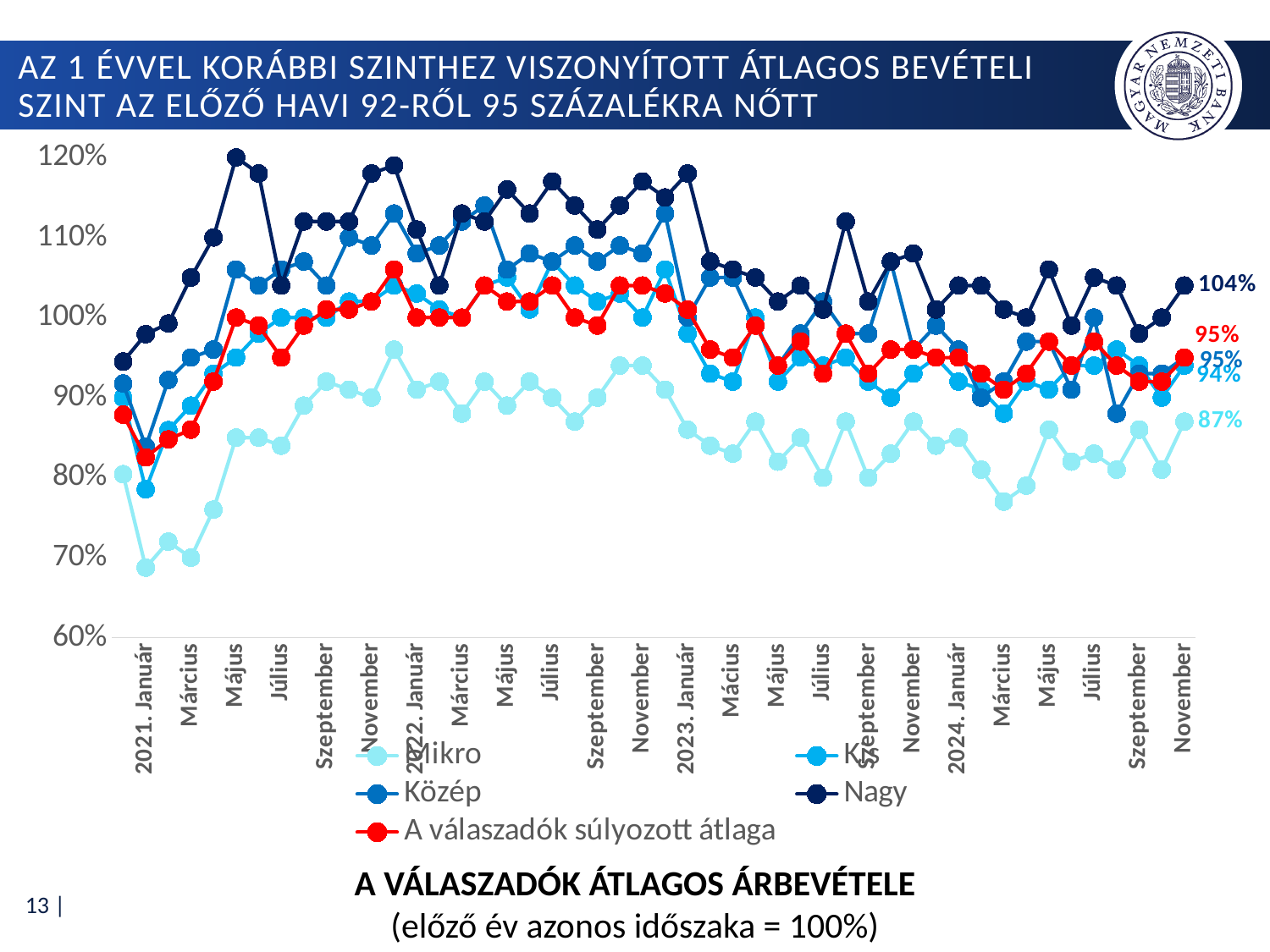
What is the value of the Nagy series at the last point (2024 November)? 104% What kind of chart is shown on the slide? line chart Which series has the lowest value at the last point (2024 November)? Mikro What is the value of the Kis series at the last point (2024 November)? 94% At the last point (2024 November), which is larger: the Nagy value or the Kis value? Nagy How many series does the legend list? 5 Which series has the highest value at the last point (2024 November)? Nagy Is the value of the Mikro series in 2021 January greater or less than 90%? less Is the value of the Nagy series in 2021 May greater or less than 110%? greater What is the value of 'A válaszadók súlyozott átlaga' at the last point (2024 November)? 95% At the last point (2024 November), what is the difference between the Nagy value and the Mikro value? 17 percentage points What is the value of the Mikro series at the last point (2024 November)? 87%